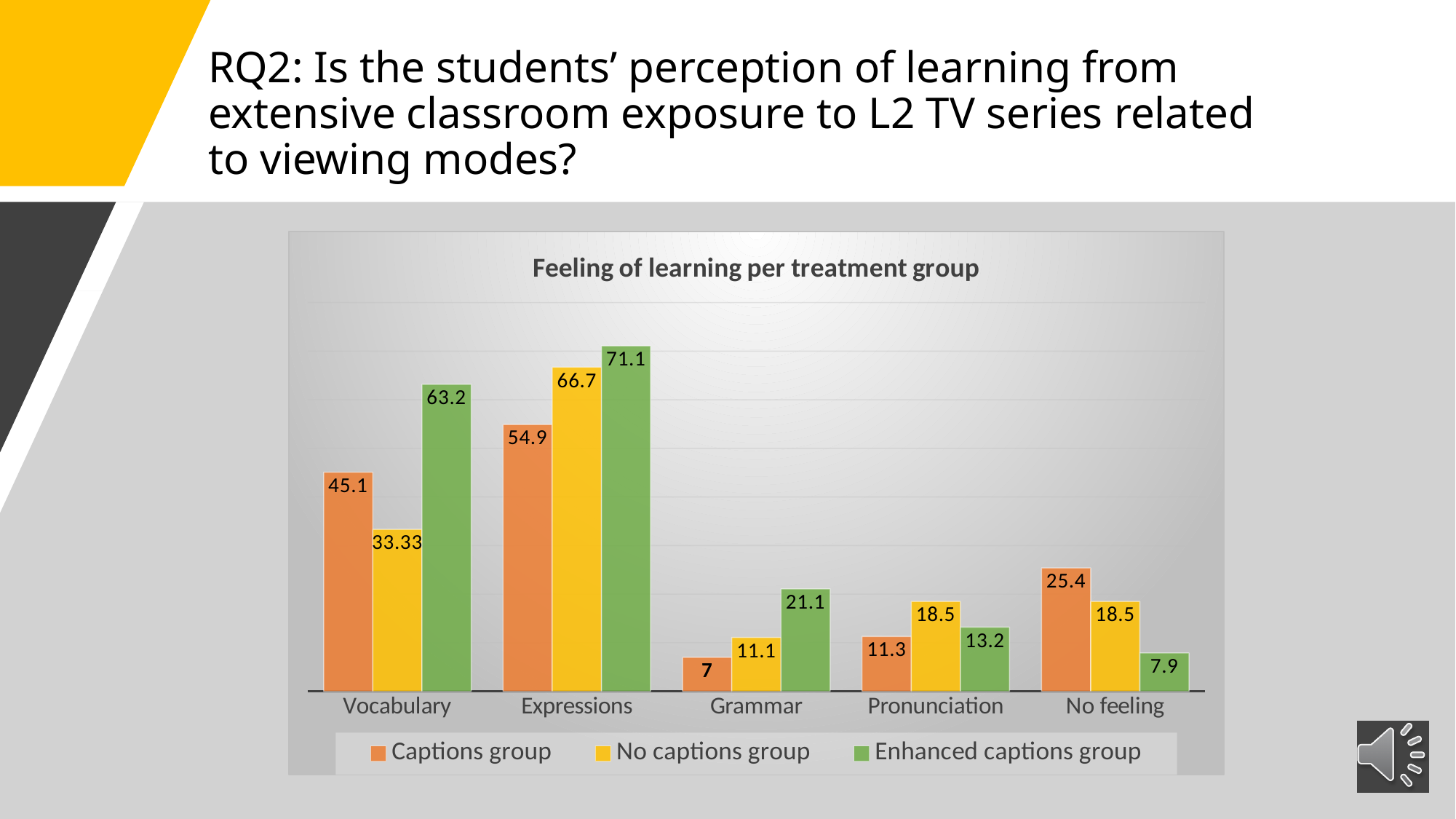
What is the title of the chart? Feeling of learning per treatment group How many categories are shown on the x axis? 5 What is the difference between the Enhanced captions group and the Captions group in the Vocabulary category? 18.1 What is the value for the Captions group in the No feeling category? 25.4 What is the difference between the No captions group and the Captions group in the Grammar category? 4.1 Which is larger in the Pronunciation category: the No captions group or the Enhanced captions group? No captions group What is the value for the Enhanced captions group in the Expressions category? 71.1 How many series does the legend list? 3 Which category has the highest value for the Captions group? Expressions Which category has the lowest value for the Enhanced captions group? No feeling What kind of chart is shown on the slide? Bar chart What is the value for the No captions group in the Vocabulary category? 33.33